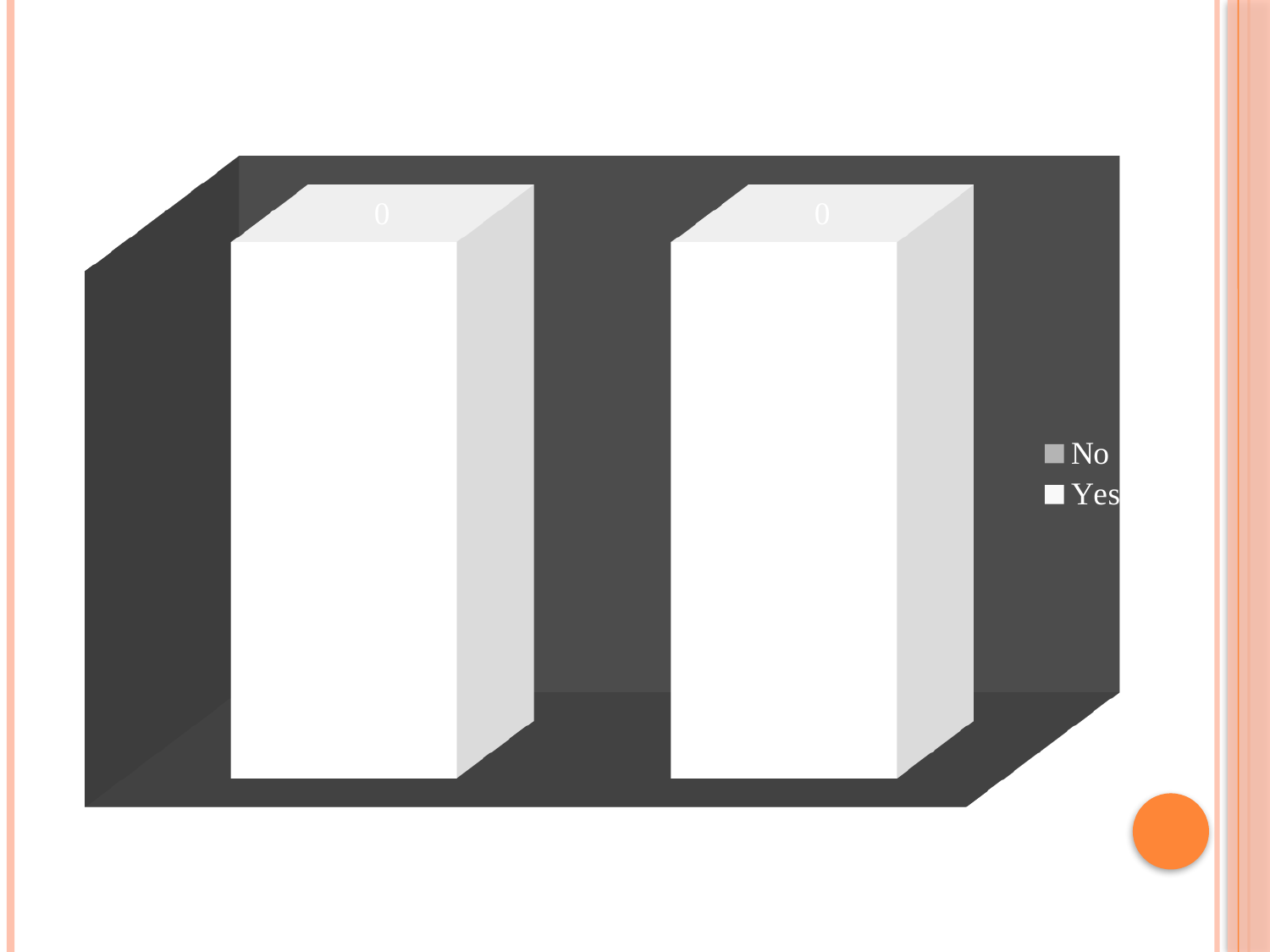
Which legend entry is shown with a white marker? Yes What value is printed as the data label on the left bar? 0 What value is printed as the data label on the right bar? 0 What are the two entries listed in the chart's legend? No, Yes What kind of chart is shown on the slide? bar chart How many bars are plotted in the chart? 2 How many series does the legend list? 2